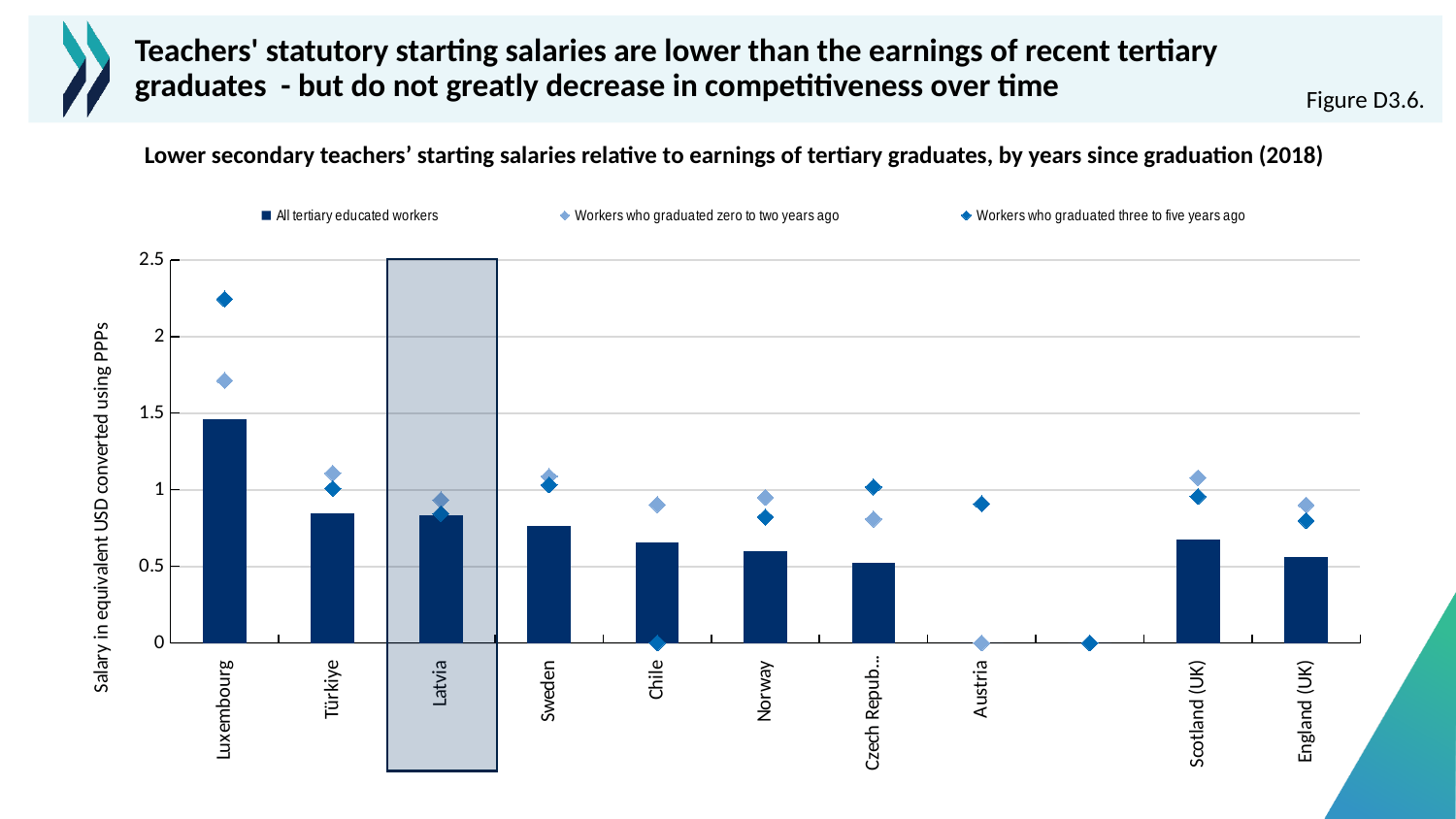
Which has the larger bar for all tertiary educated workers, Sweden or Czech Republic? Sweden Is the bar for Norway (all tertiary educated workers) greater or less than 0.5? greater Which country is highlighted with a shaded box on the chart? Latvia What kind of chart is shown on the slide? Bar chart Which has the larger bar for all tertiary educated workers, Luxembourg or Sweden? Luxembourg How many series does the legend list? 3 Is the bar for Luxembourg (all tertiary educated workers) greater or less than 1? greater Is the marker for workers who graduated zero to two years ago in Luxembourg greater or less than 1.5? greater What is the label of the vertical axis? Salary in equivalent USD converted using PPPs Which country has the highest bar for all tertiary educated workers? Luxembourg